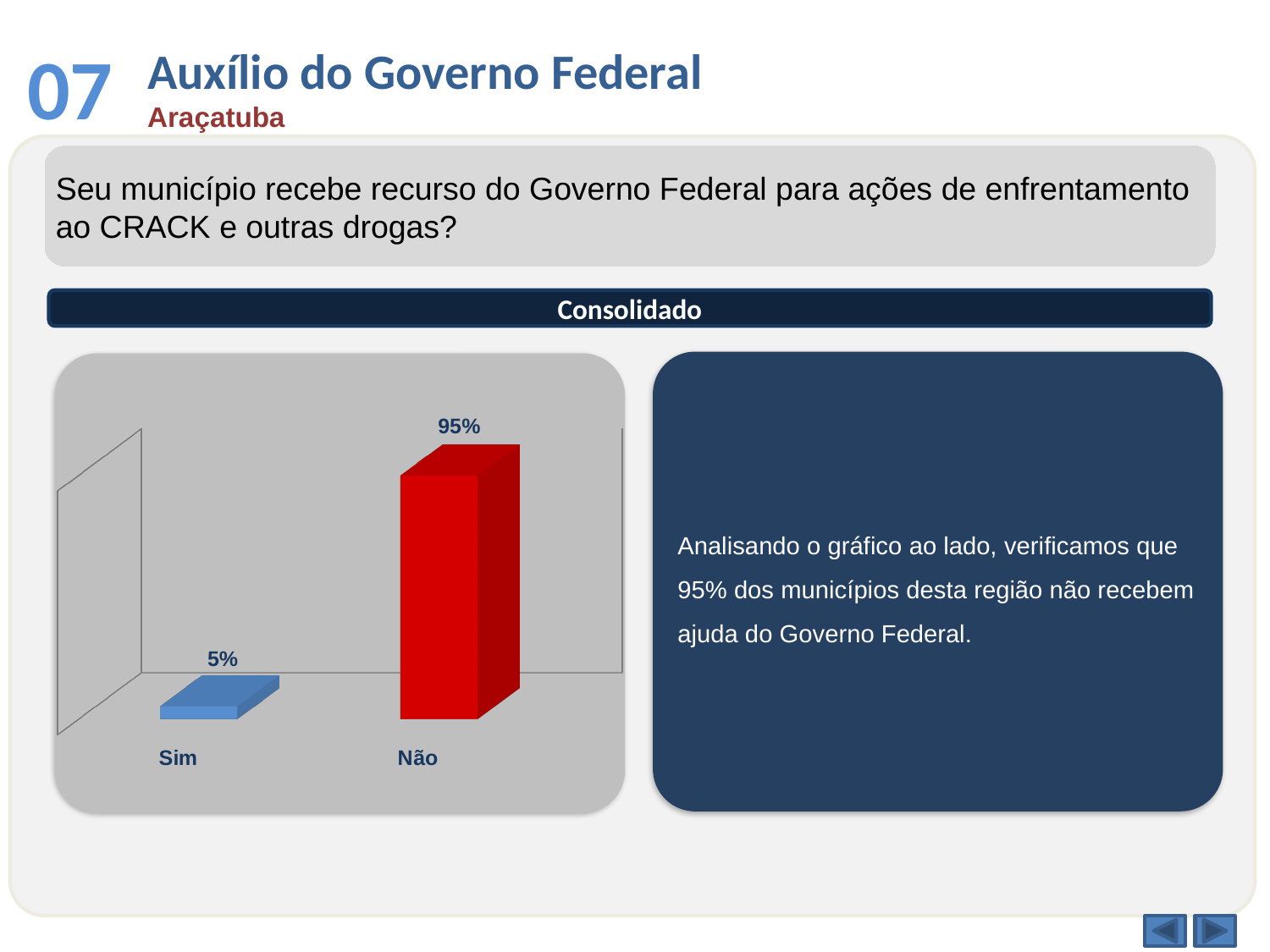
What is the value for "Sim" in the chart? 5% What is the total of the two values shown in the chart? 100% What colour is the bar for "Sim"? Blue What kind of chart is shown on the slide? Bar chart Which category has the lowest value in the chart? Sim What is the difference between the values for "Não" and "Sim"? 90% Which category has the highest value in the chart? Não How many categories are shown in the chart? 2 What is the value for "Não" in the chart? 95% What colour is the bar for "Não"? Red Which is larger, the value for "Sim" or the value for "Não"? Não